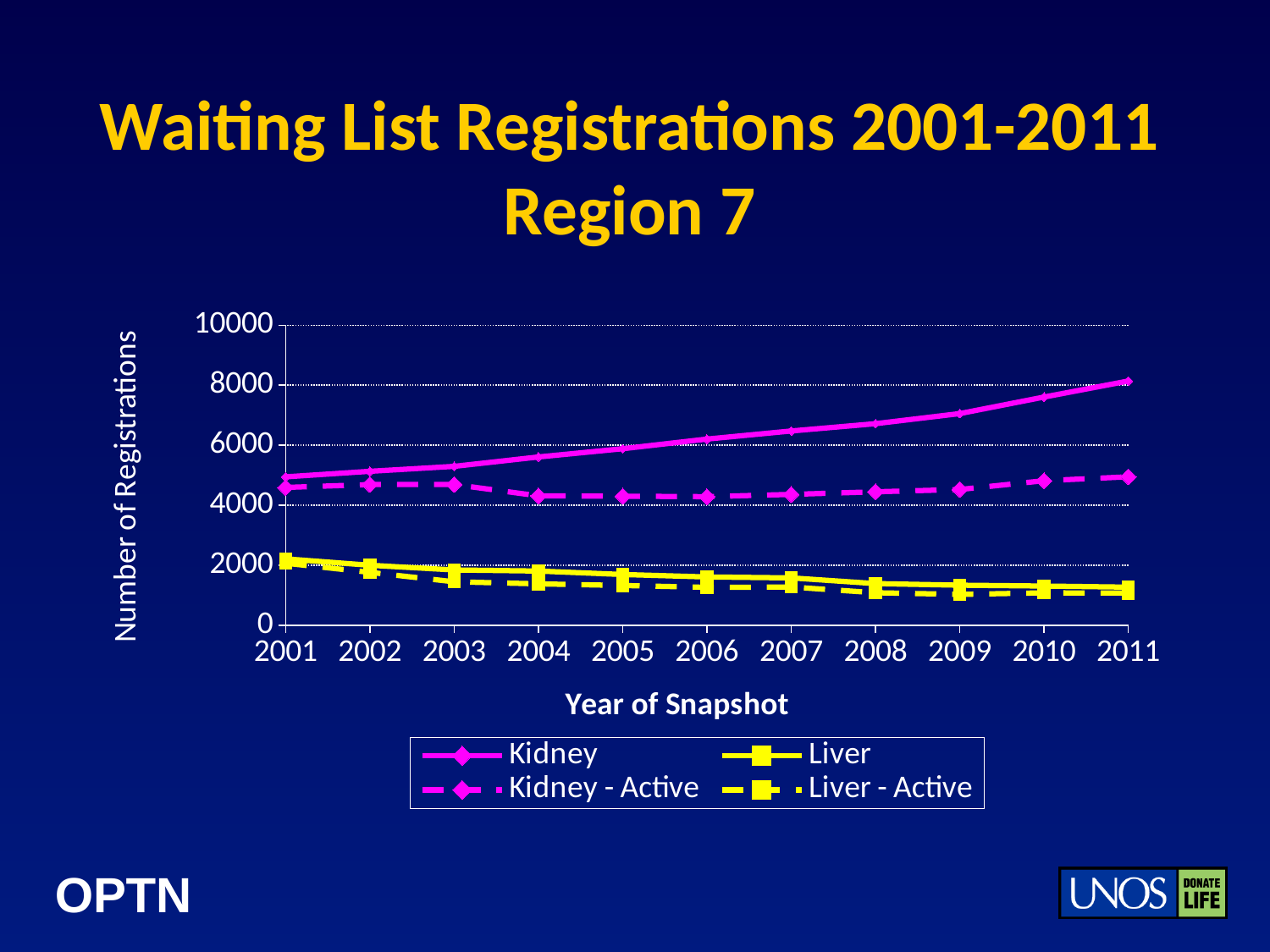
How many years are plotted along the x axis? 11 Which series has the highest value in 2011? Kidney How many series does the legend list? 4 What kind of chart is shown on the slide? line chart Is the Kidney value for 2001 greater or less than 6000? less Is the Kidney value for 2009 greater or less than 6000? greater In which year does the Kidney series reach its highest value? 2011 What is the label of the x axis? Year of Snapshot In 2011, which is larger, Kidney or Kidney - Active? Kidney Is the Liver value for 2011 greater or less than 2000? less Does the Liver series rise or fall from 2001 to 2011? fall Does the Kidney series rise or fall from 2001 to 2011? rise